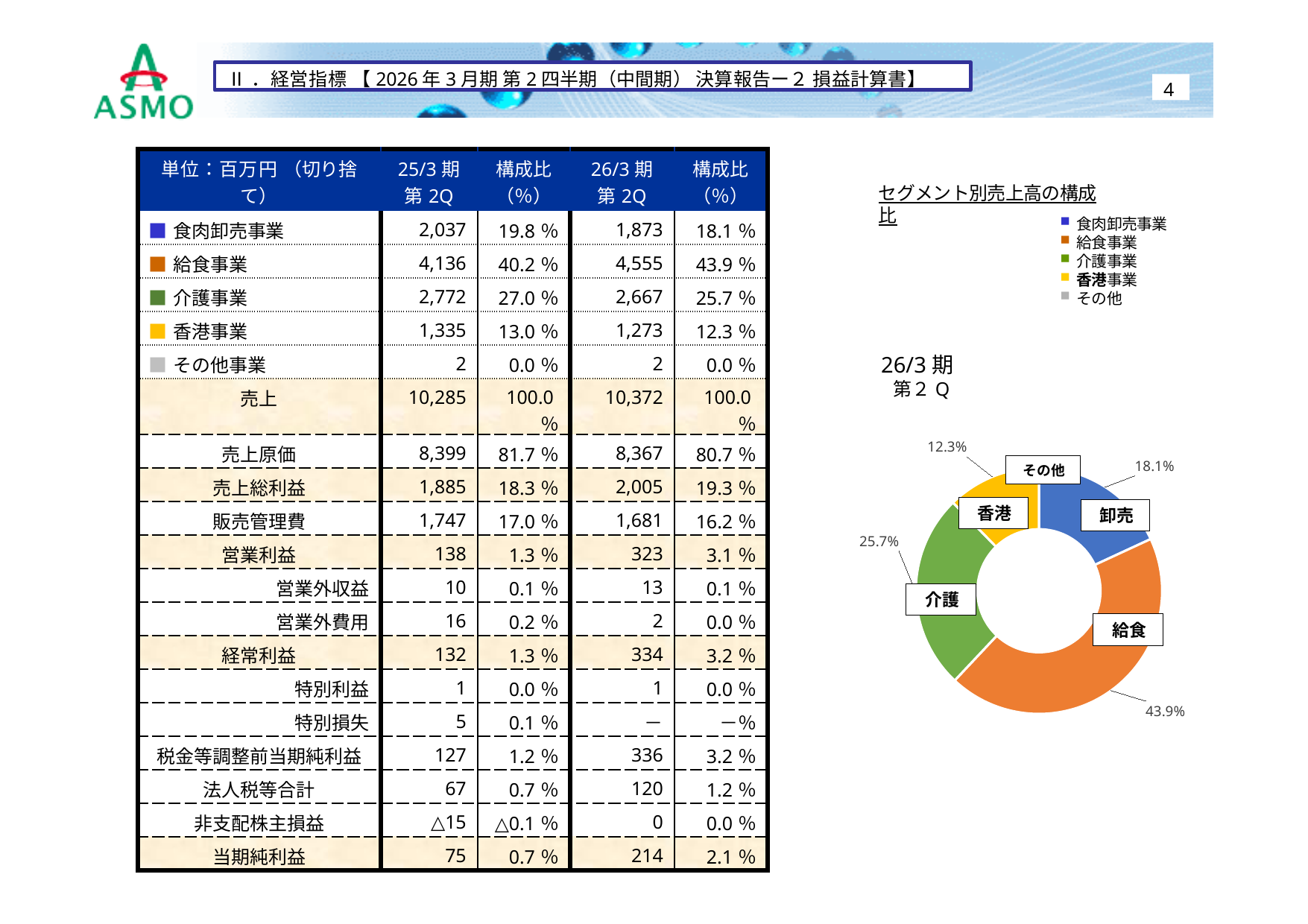
Which segment has the largest share in the segment sales composition chart? 給食事業 In the segment sales composition chart, what share does 介護 (介護事業) hold? 25.7% What colour represents 給食事業 in the segment sales composition chart? Orange What kind of chart is shown on the right side of the slide? Pie chart (donut) In the segment sales composition chart, which is larger: the share of 介護 or the share of 卸売? 介護 How many entries does the legend of the segment sales composition chart list? 5 In the segment sales composition chart, what share does 給食 (給食事業) hold? 43.9% Which segment has the smallest share in the segment sales composition chart? その他 In the segment sales composition chart, what share does 香港 (香港事業) hold? 12.3% Which period does the segment sales composition chart cover? 26/3期 第2Q In the segment sales composition chart, what is the difference between the share of 給食 and the share of 介護? 18.2%